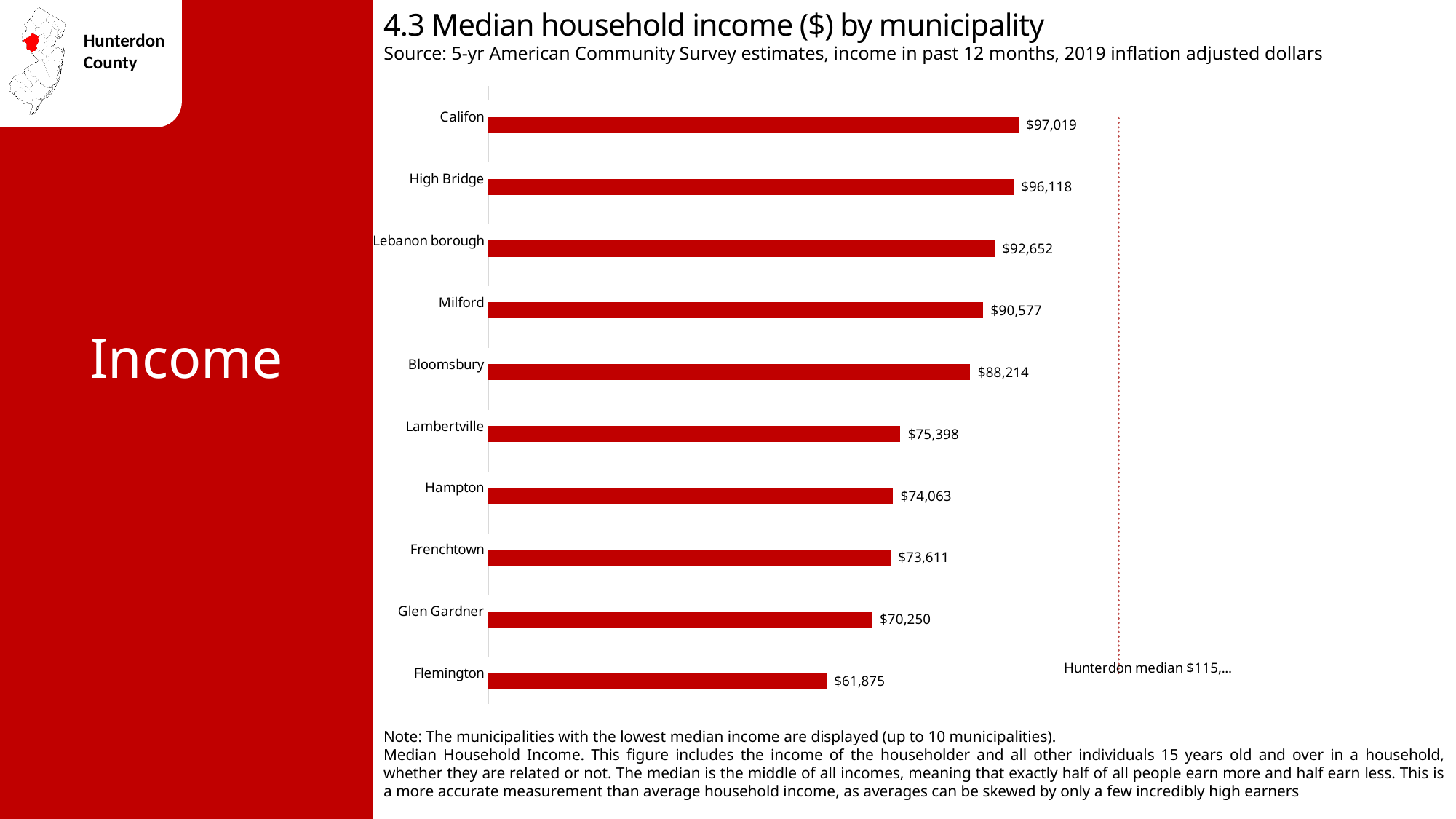
Which municipality has the highest median household income shown on the chart? Califon What is the median household income for Lambertville? $75,398 Which municipality has the lowest median household income shown on the chart? Flemington What is the difference between the median household income of Milford and Bloomsbury? $2,363 What is the title of the chart? 4.3 Median household income ($) by municipality What is the median household income for Glen Gardner? $70,250 Which has a higher median household income, Hampton or Frenchtown? Hampton What is the median household income for Flemington? $61,875 What kind of chart is used to show median household income by municipality? Bar chart What is the difference between the median household income of Califon and Flemington? $35,144 How many municipalities are shown on the chart? 10 What is the median household income for Califon? $97,019